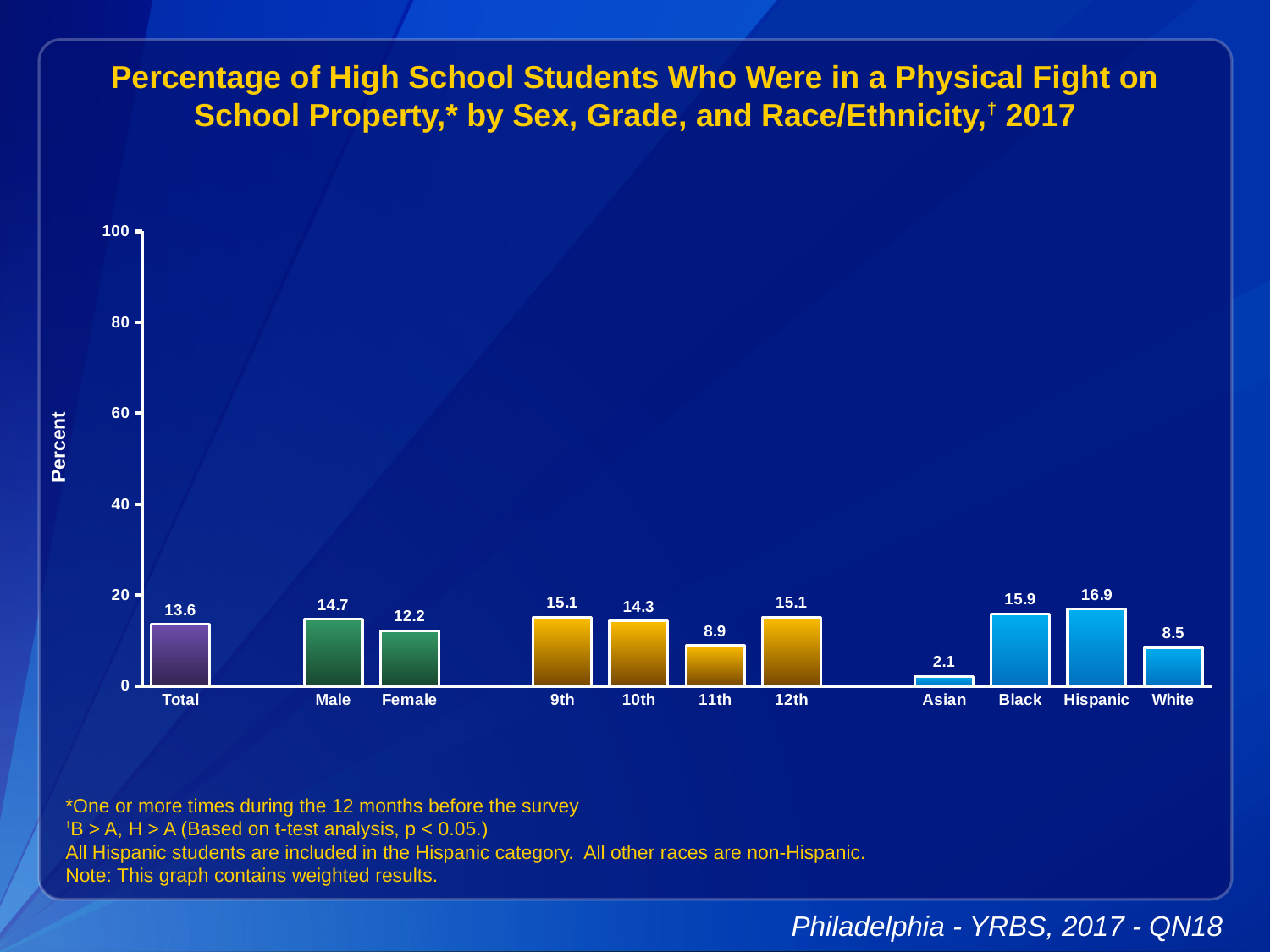
What is the value for 11th grade? 8.9 What is the difference between the Male and Female values? 2.5 What is the value for Total? 13.6 What is the value for Asian students? 2.1 How many categories are shown on the x axis? 11 Which category has the highest value? Hispanic Which category has the lowest value? Asian What is the label on the y axis? Percent Is the value for 9th grade greater or less than 20? less Which is larger, the value for Black or the value for White? Black What kind of chart is this? bar chart What percentage of Female students were in a physical fight on school property? 12.2